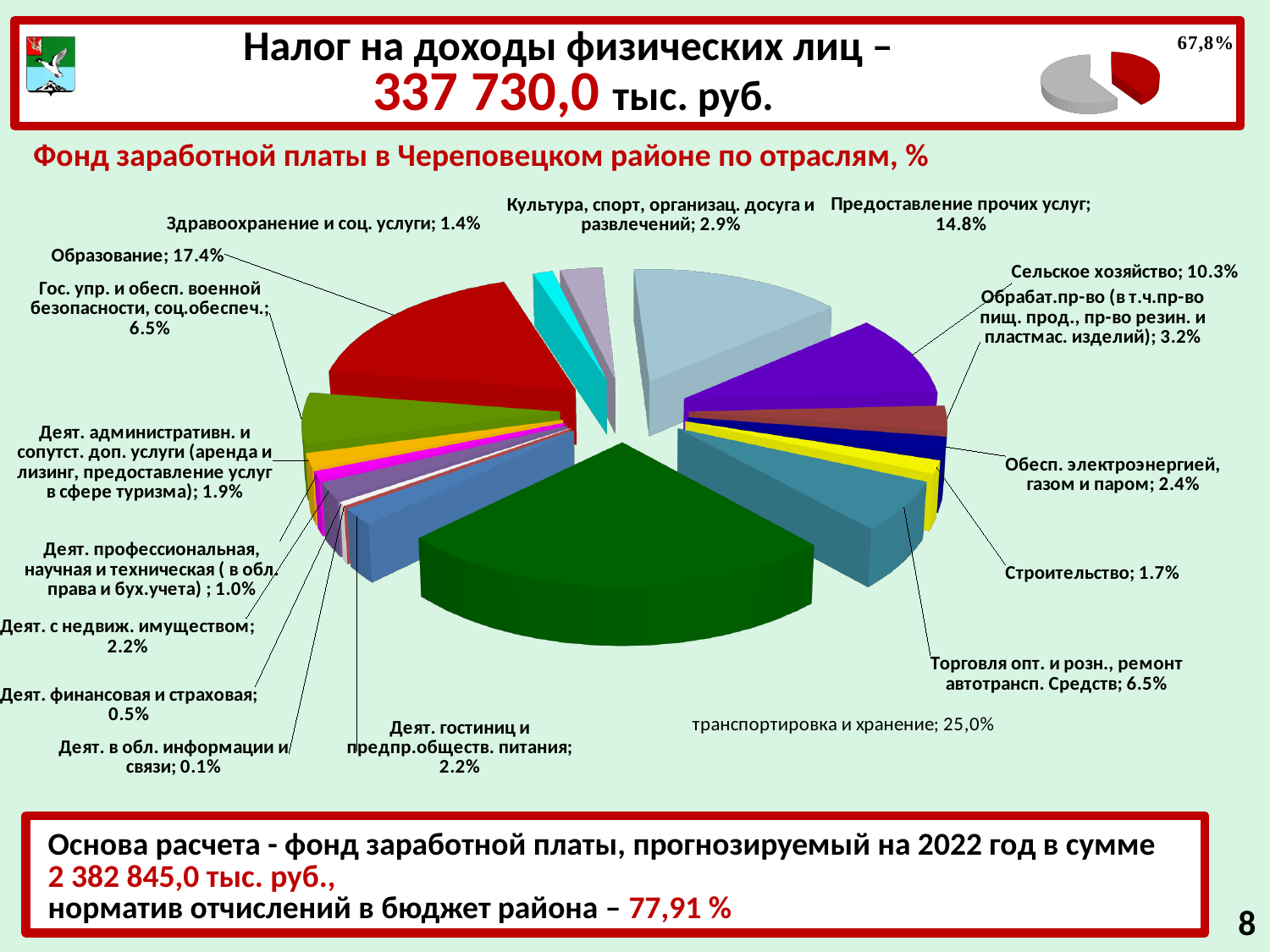
What is the value shown for 'Образование' in the pie chart? 17.4% What is the title of the pie chart on the slide? Фонд заработной платы в Череповецком районе по отраслям, % Which industry has the largest share of the wage fund in the pie chart? транспортировка и хранение What is the value for 'Предоставление прочих услуг'? 14.8% Which has a larger share: 'Сельское хозяйство' or 'Торговля опт. и розн., ремонт автотрансп. Средств'? Сельское хозяйство What is the difference between the shares of 'Образование' and 'Предоставление прочих услуг'? 2.6% What percentage is shown for 'Сельское хозяйство'? 10.3% What type of chart is used to show the wage fund by industry in Череповецкий район? pie chart What percentage is labelled on the small pie chart in the top right corner of the slide? 67,8% How many industry categories are shown in the pie chart? 17 What share of the wage fund does 'транспортировка и хранение' account for? 25,0% Which industry has the smallest share of the wage fund in the pie chart? Деят. в обл. информации и связи